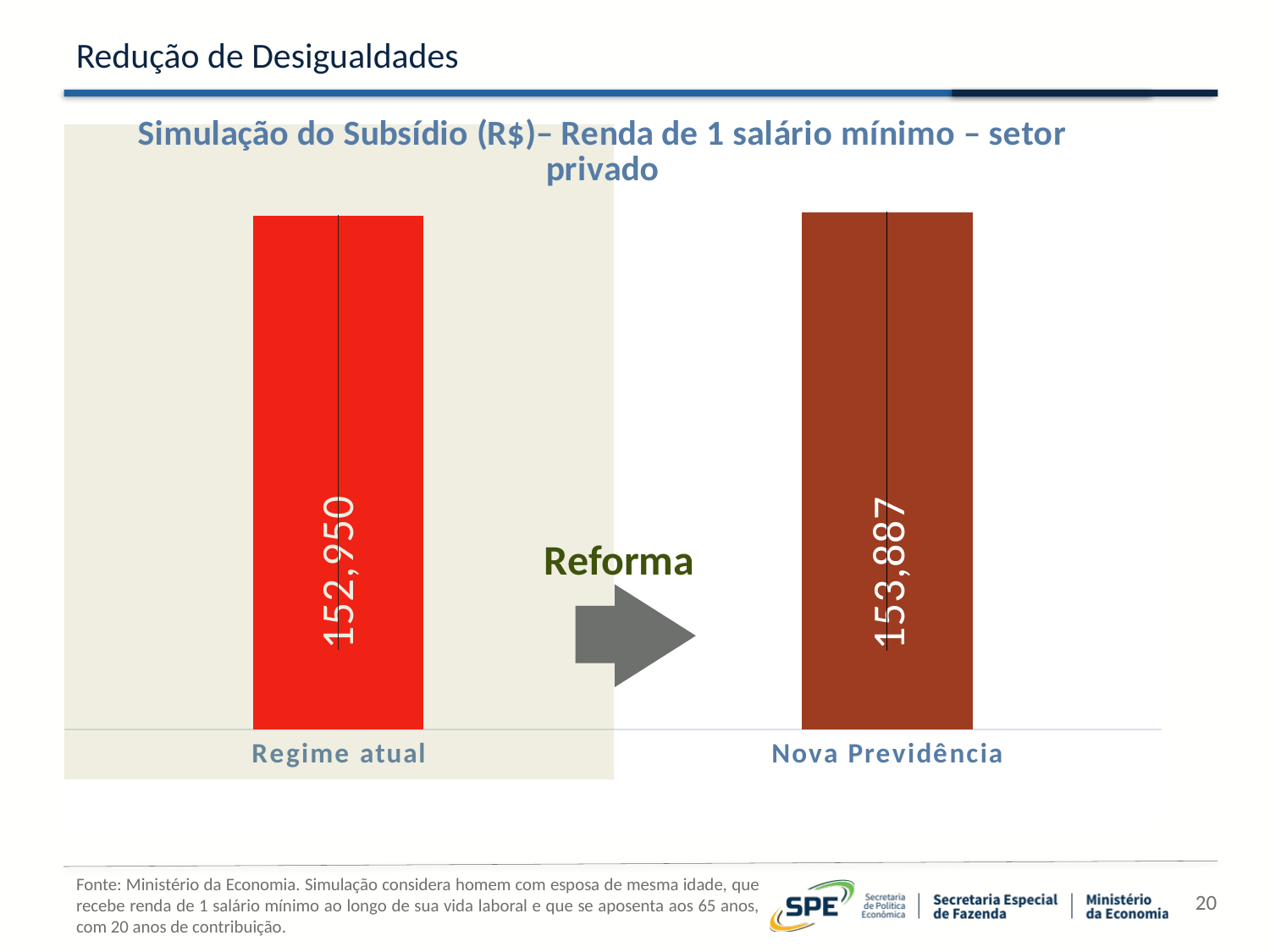
What is the value shown for Regime atual? 152,950 Which category has the lowest value? Regime atual Which category has the higher value, Regime atual or Nova Previdência? Nova Previdência What word is written above the arrow between the two bars? Reforma What is the value shown for Nova Previdência? 153,887 What kind of chart is shown on the slide? Bar chart Which category has the highest value? Nova Previdência Do the values rise or fall from Regime atual to Nova Previdência? Rise How many categories are shown in the chart? 2 What is the difference between the values for Nova Previdência and Regime atual? 937 What is the title of the chart? Simulação do Subsídio (R$)– Renda de 1 salário mínimo – setor privado